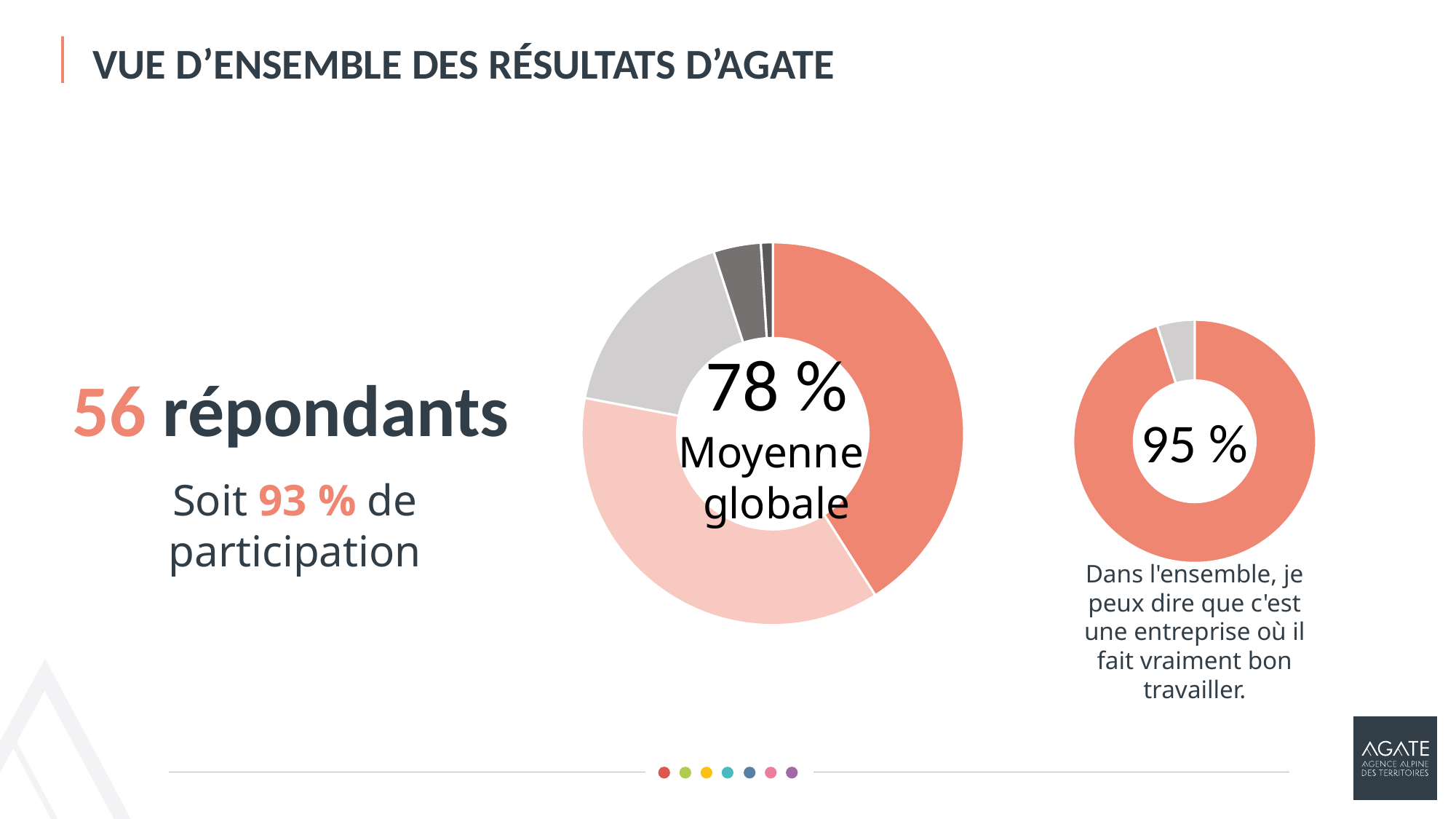
In the large donut chart, is the light grey slice larger or smaller than the light pink slice? Smaller What percentage is printed in the centre of the large donut chart? 78 % What statement is written below the small donut chart on the right? Dans l'ensemble, je peux dire que c'est une entreprise où il fait vraiment bon travailler. What kind of chart is the large chart in the centre of the slide? Donut (pie) chart What kind of chart is the small chart on the right of the slide? Donut (pie) chart How many slices does the small donut chart on the right have? 2 In the small donut chart on the right, which colour slice is larger, the salmon one or the grey one? The salmon one How many slices does the large donut chart have? 5 What label accompanies the 78 % in the centre of the large donut chart? Moyenne globale In the large donut chart, which colour slice is the smallest? The small dark grey slice at the top What percentage is printed in the centre of the small donut chart on the right? 95 % How many donut charts are shown on the slide? 2